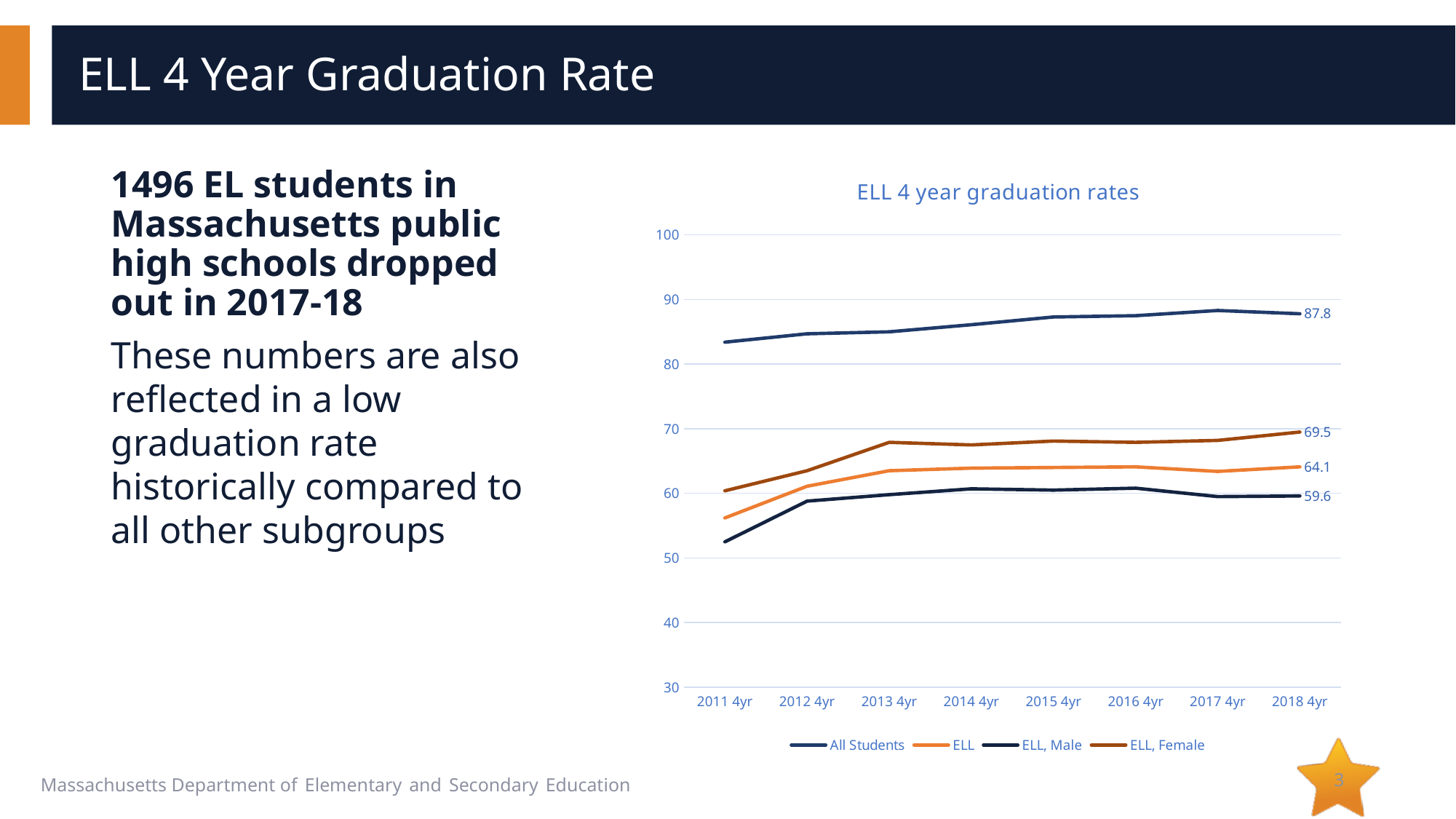
What is the difference between the ELL, Female and ELL, Male values at 2018 4yr? 9.9 Does the All Students line generally rise or fall from 2011 4yr to 2018 4yr? rise How many points are plotted along the x axis for each series? 8 What is the title of the chart? ELL 4 year graduation rates What is the value for ELL at 2018 4yr? 64.1 What is the value for ELL, Female at 2018 4yr? 69.5 Is the value for ELL, Male at 2011 4yr greater or less than 60? less How many series does the chart legend list? 4 Which series has the highest value at 2018 4yr? All Students What is the value for ELL, Male at 2018 4yr? 59.6 What is the value for All Students at 2018 4yr? 87.8 What type of chart is shown on the slide? line chart